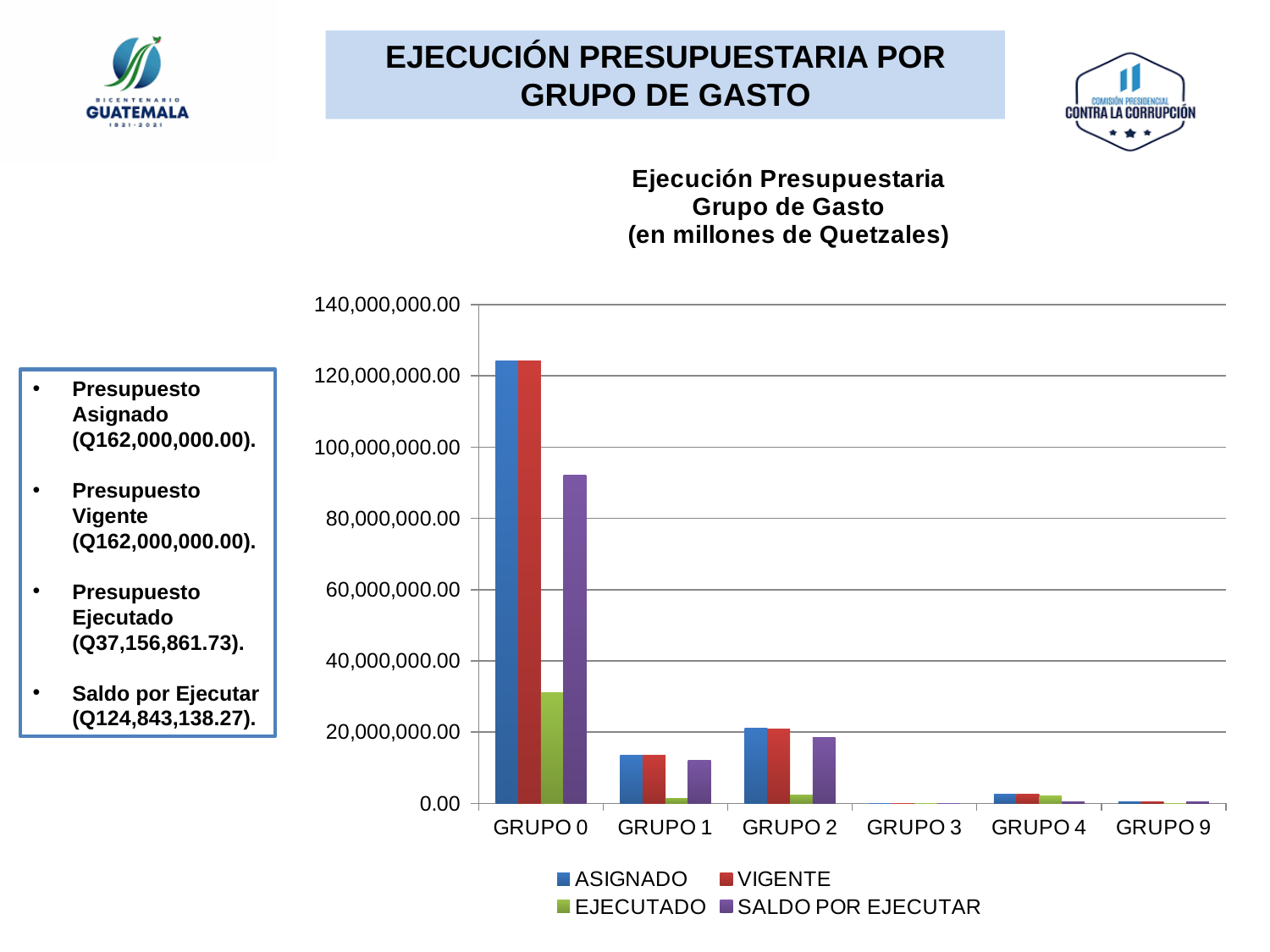
How many series does the chart legend list? 4 Is the SALDO POR EJECUTAR value for GRUPO 0 greater or less than 80,000,000.00? greater Which group has the larger ASIGNADO value, GRUPO 1 or GRUPO 2? GRUPO 2 Is the ASIGNADO value for GRUPO 0 greater or less than 100,000,000.00? greater Is the ASIGNADO value for GRUPO 1 greater or less than 20,000,000.00? less What kind of chart is shown on the slide? bar chart Which group has the highest ASIGNADO value? GRUPO 0 How many groups (categories) are shown on the x axis of the chart? 6 Which group has the larger EJECUTADO value, GRUPO 0 or GRUPO 2? GRUPO 0 Which group has the lowest values across all series? GRUPO 3 Which series is shown in green in the chart legend? EJECUTADO